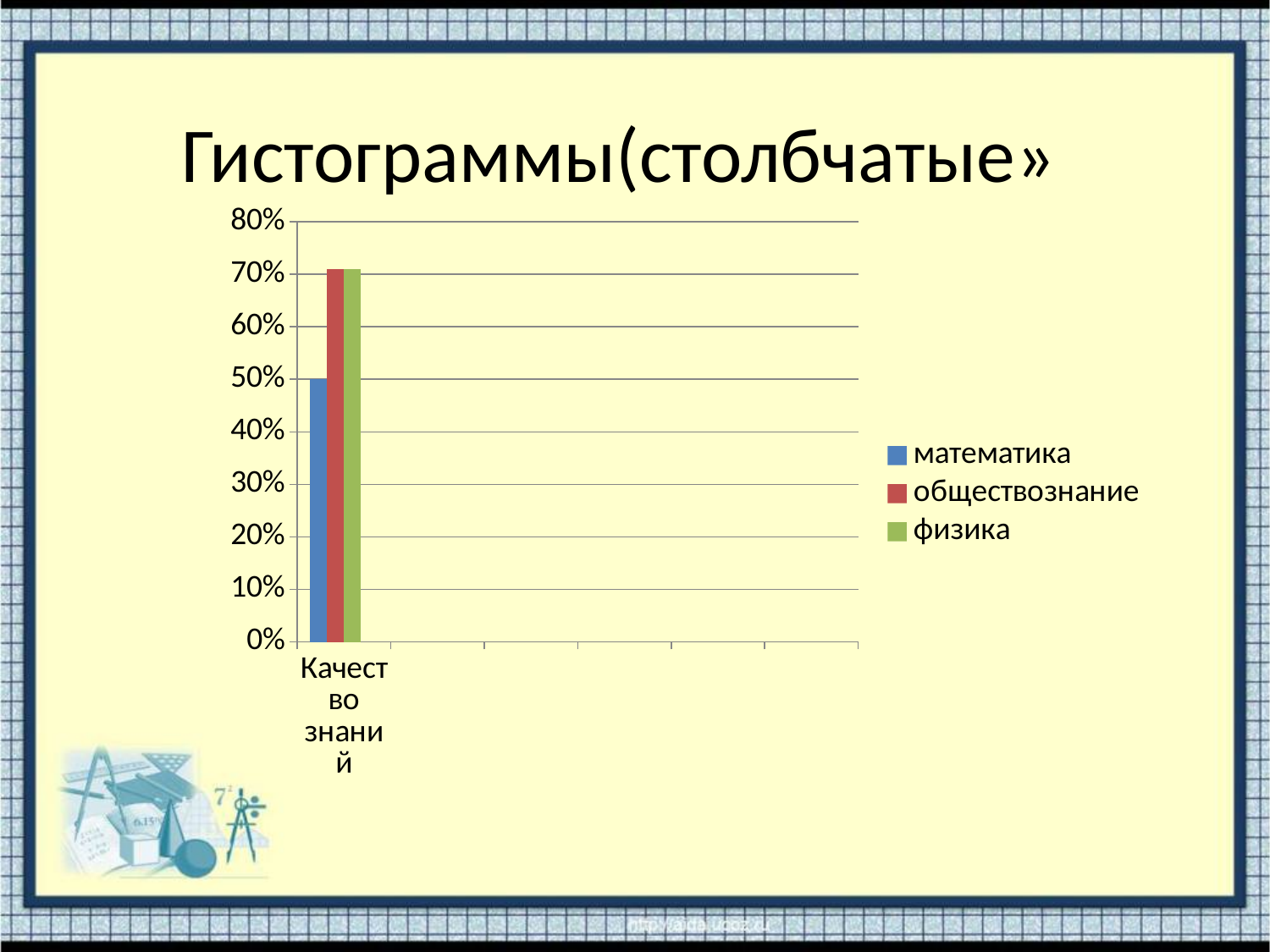
What is the title of the slide? Гистограммы(столбчатые» What kind of chart is shown on the slide? bar chart Is the value for математика greater or less than 60%? less Which is larger, the value for физика or the value for математика? физика Is the value for физика greater or less than 60%? greater Which is larger, the value for обществознание or the value for математика? обществознание Which series is shown in green? физика Which series has the lowest value for Качество знаний? математика How many categories are shown on the x axis? 1 Is the value for обществознание greater or less than 60%? greater How many series does the legend list? 3 What is the value for математика? 50%